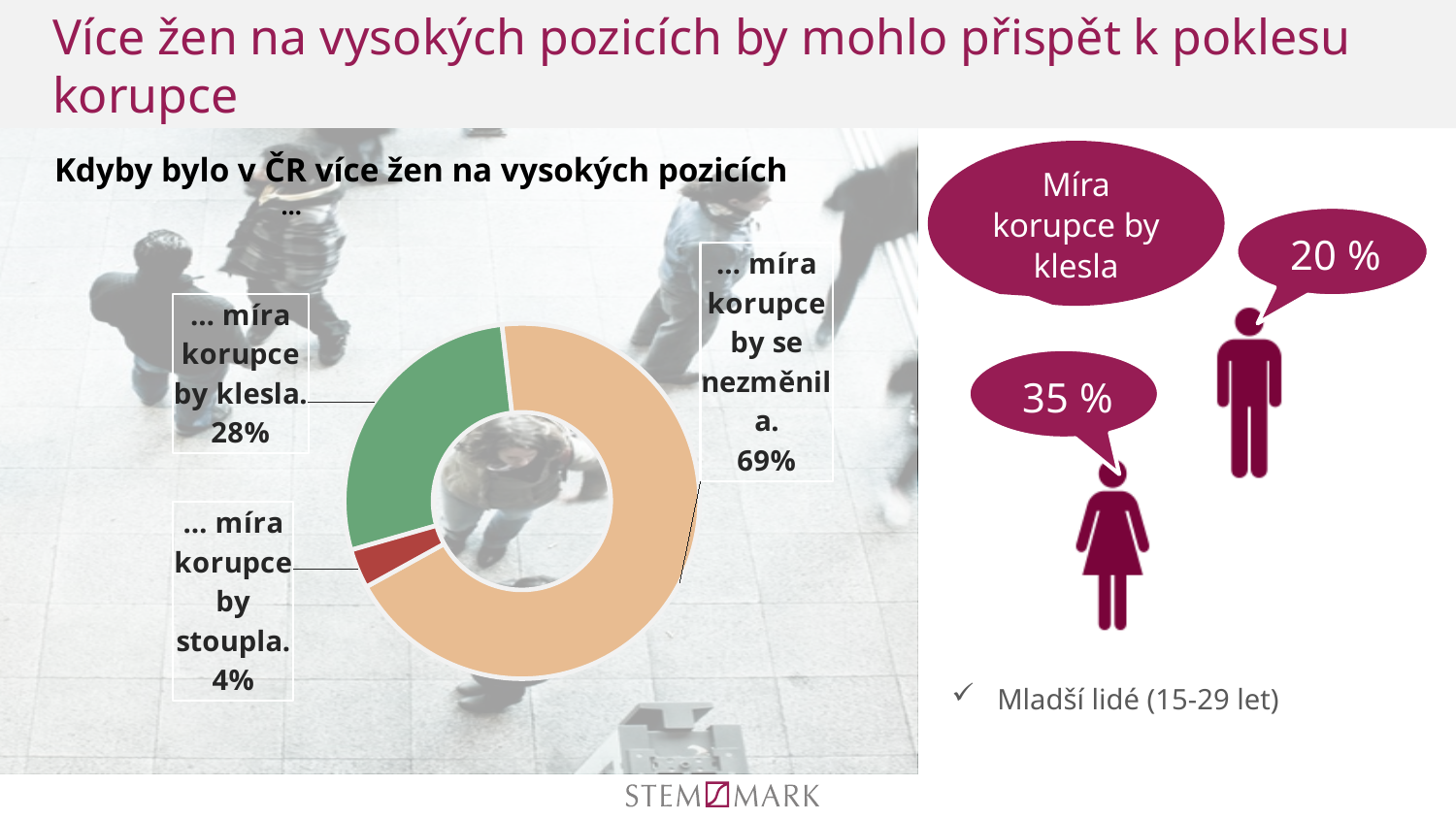
What percentage of respondents said the level of corruption would decrease ("… míra korupce by klesla.")? 28% What percentage of respondents said the level of corruption would not change ("… míra korupce by se nezměnila.")? 69% What is the difference between the share for "by klesla" and the share for "by stoupla"? 24 percentage points How many percentage points larger is the share for "by se nezměnila" than for "by klesla"? 41 percentage points Which is larger: the share for "míra korupce by klesla" or for "míra korupce by stoupla"? míra korupce by klesla Which response has the largest share in the donut chart? … míra korupce by se nezměnila. What percentage of respondents said the level of corruption would increase ("… míra korupce by stoupla.")? 4% What colour is the slice for "míra korupce by klesla"? Green How many response categories are shown in the donut chart? 3 What type of chart is used on the slide? Pie (donut) chart What is the title of the chart? Kdyby bylo v ČR více žen na vysokých pozicích … Which response has the smallest share in the donut chart? … míra korupce by stoupla.